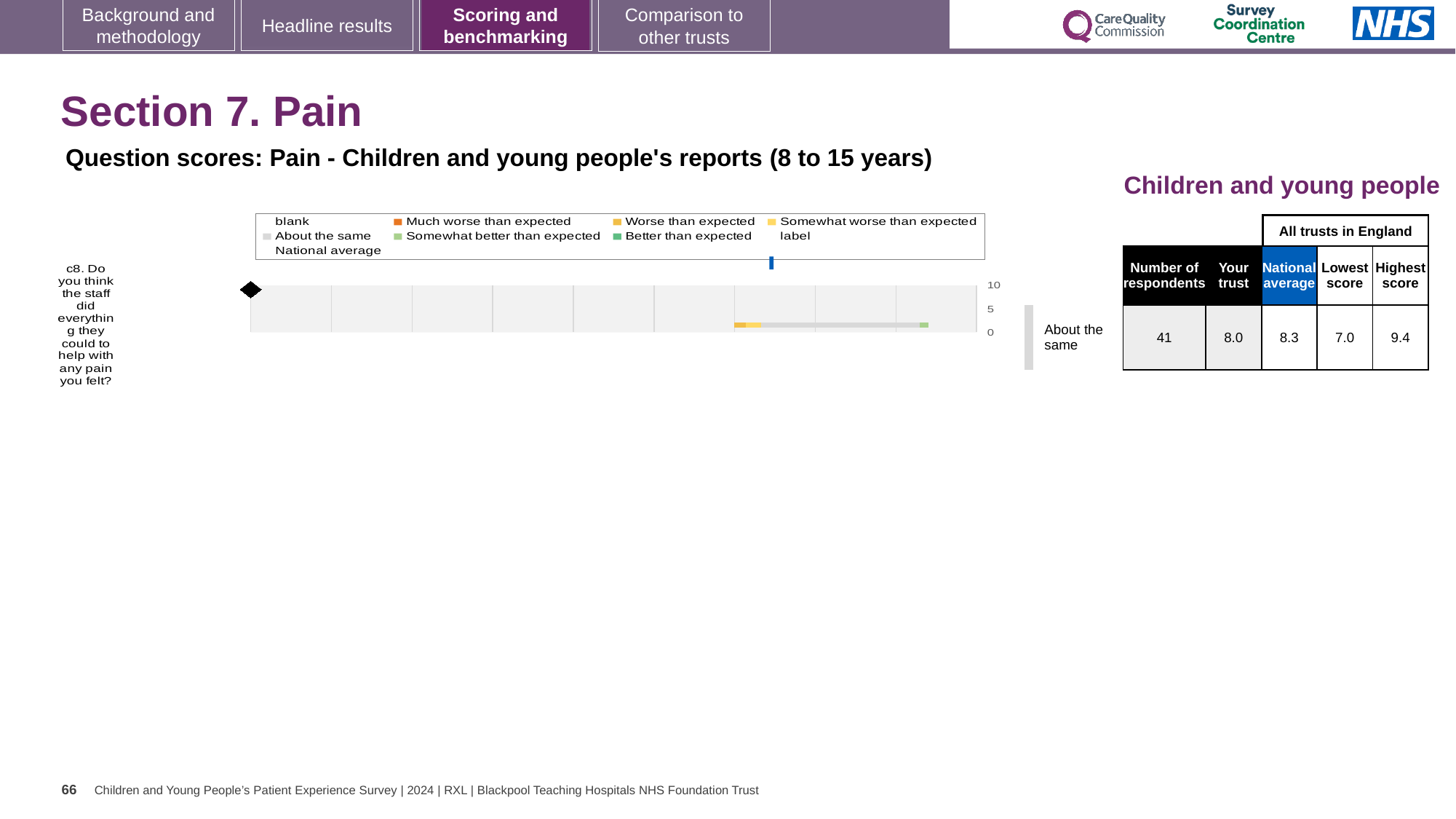
Which benchmark category is shown for question c8 (staff did everything to help with pain)? About the same What kind of chart is shown for question c8 on this slide? bar chart What is the 'Your trust' score for question c8 in the table next to the chart? 8.0 For question c8, which is larger: the trust's score or the national average? National average By how much does the national average exceed the trust's score for question c8? 0.3 How many survey questions are plotted in the chart on this slide? 1 What is the national average score for question c8? 8.3 What is the difference between the highest and lowest trust scores for question c8? 2.4 What is the highest value shown on the chart's score axis? 10 How many respondents answered question c8? 41 What is the highest score among all trusts in England for question c8? 9.4 What is the lowest score among all trusts in England for question c8? 7.0